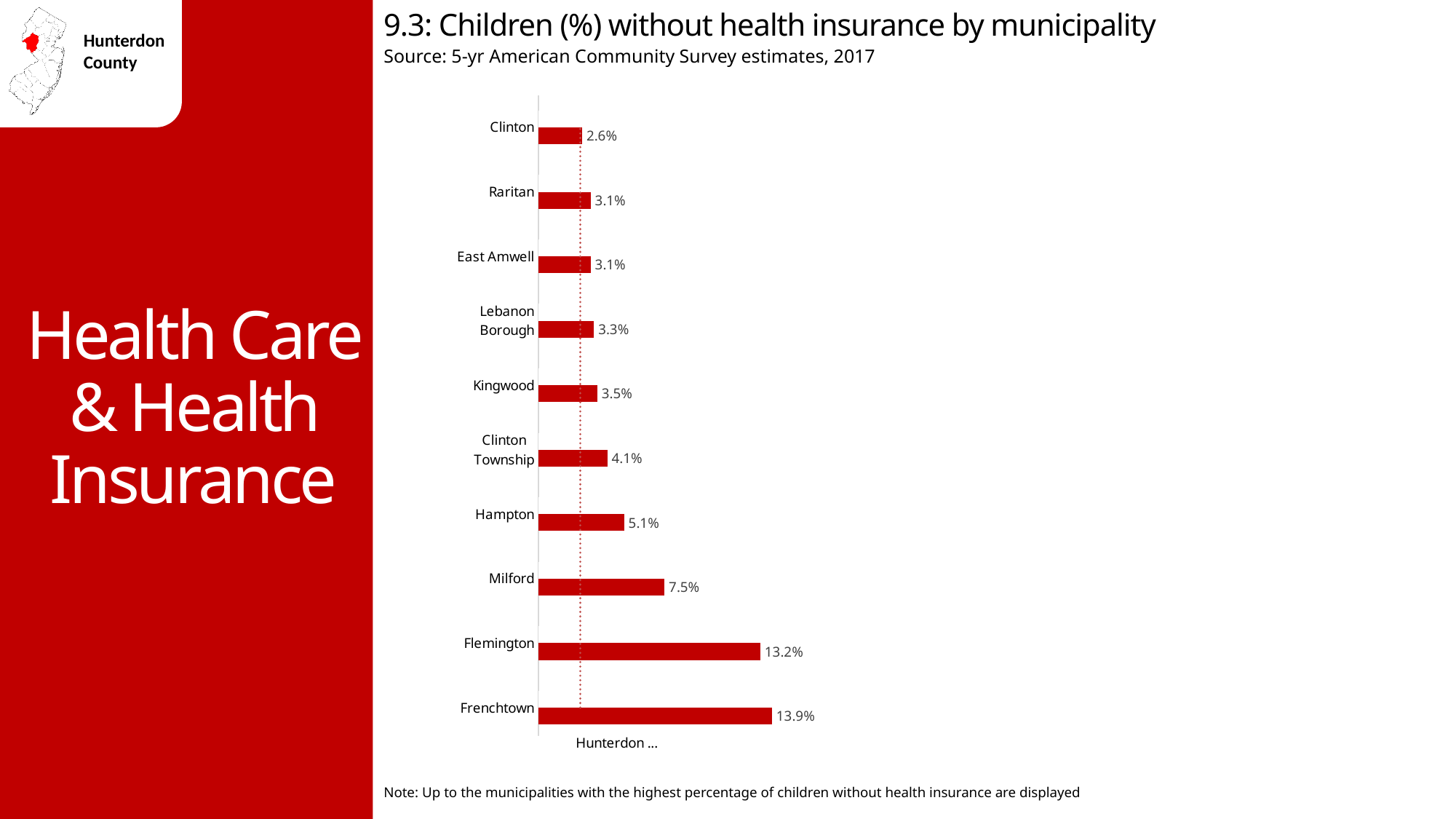
Which municipality has the highest percentage of children without health insurance? Frenchtown What is the title of the chart? 9.3: Children (%) without health insurance by municipality What is the difference between the values for Milford and Hampton? 2.4% What kind of chart is shown on the slide? Bar chart What percentage of children in Frenchtown are without health insurance? 13.9% What is the value shown for Flemington? 13.2% What is the source of the data shown in the chart? 5-yr American Community Survey estimates, 2017 How many municipalities are shown in the chart? 10 Which has a higher value, Kingwood or Lebanon Borough? Kingwood Which municipality has the lowest percentage of children without health insurance? Clinton What percentage is shown for Clinton Township? 4.1% What is the difference between the values for Frenchtown and Flemington? 0.7%